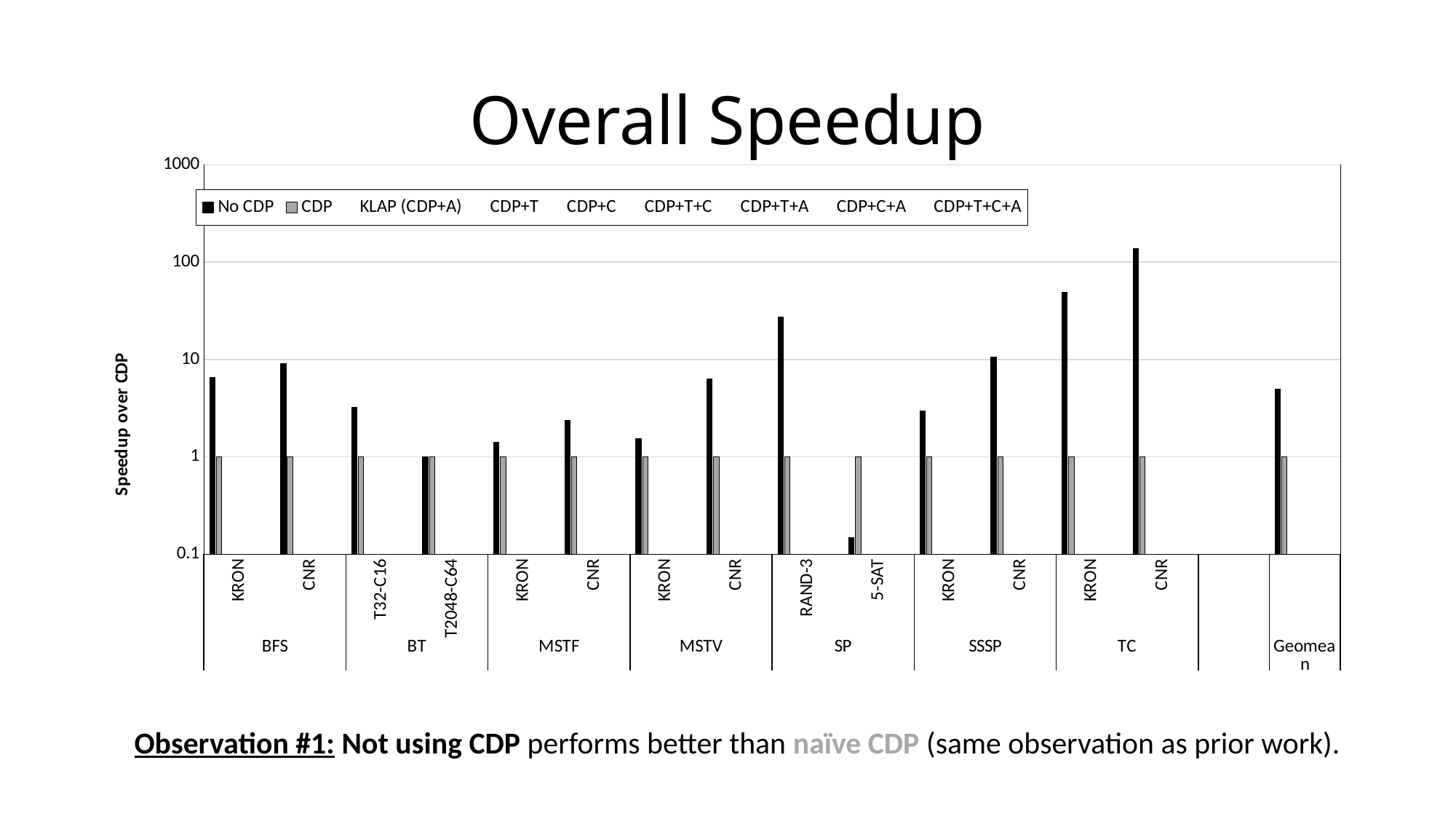
What is the CDP value for Geomean? 1 What is the label of the vertical axis? Speedup over CDP Which benchmark input has the lowest No CDP bar? 5-SAT under SP What is the title of the chart? Overall Speedup Is the No CDP value for RAND-3 under SP greater or less than 10? greater What kind of chart is shown on the slide? bar chart Which is larger, the No CDP value for KRON under TC or the No CDP value for KRON under BFS? KRON under TC Is the No CDP value for CNR under TC greater or less than 100? greater Is the No CDP value for 5-SAT under SP greater or less than 1? less Which benchmark input has the highest No CDP bar? CNR under TC What is the CDP value for KRON under BFS? 1 How many series does the legend list? 9